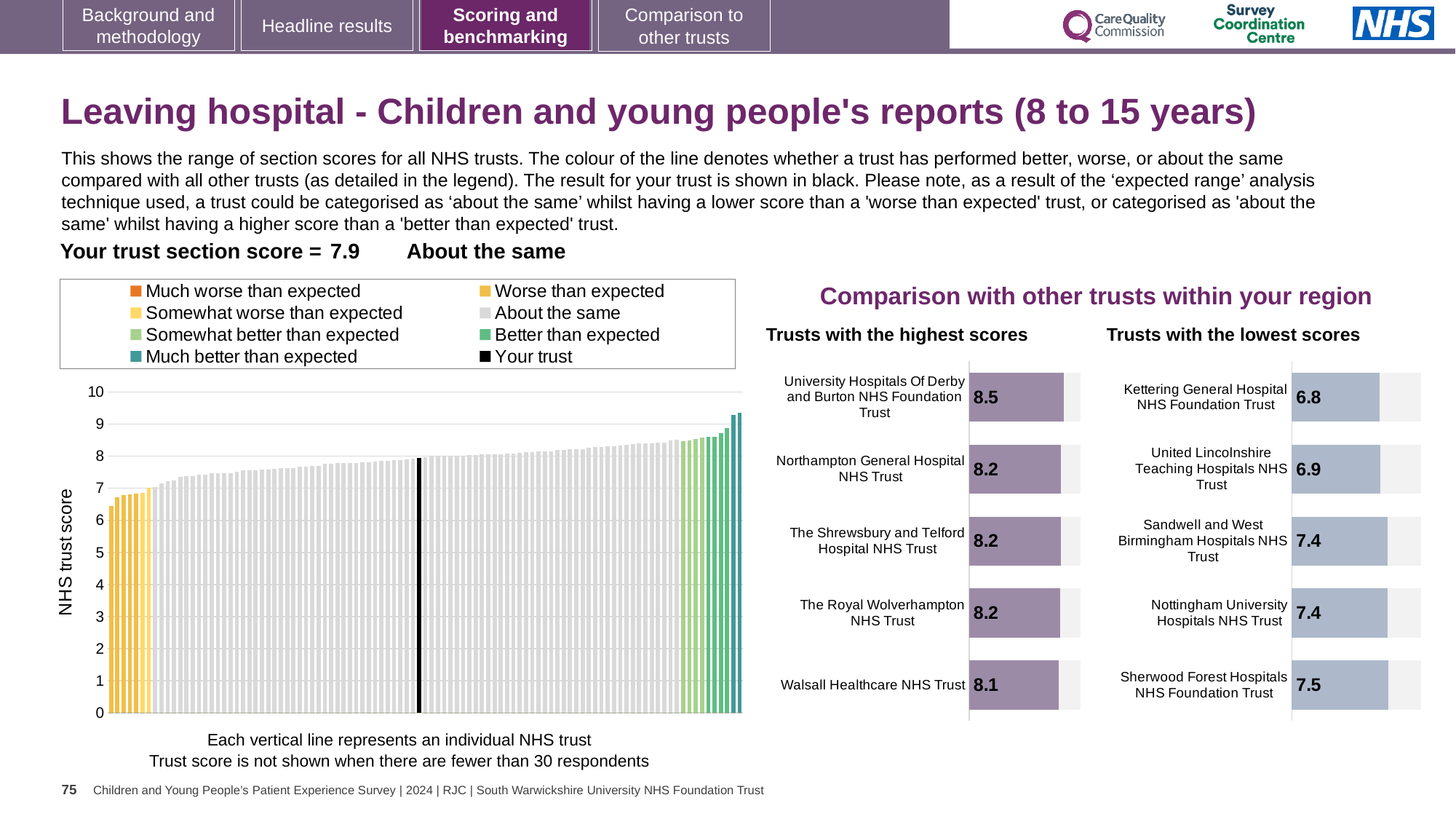
In the main chart on the left showing all NHS trusts, what is the section score for your trust (the black line)? 7.9 How many entries does the legend above the main chart on the left list? 8 In the 'Trusts with the lowest scores' chart, which has the higher score: United Lincolnshire Teaching Hospitals NHS Trust or Kettering General Hospital NHS Foundation Trust? United Lincolnshire Teaching Hospitals NHS Trust In the 'Trusts with the lowest scores' chart, what is the score for Kettering General Hospital NHS Foundation Trust? 6.8 In the 'Trusts with the highest scores' chart, which trust has the highest score? University Hospitals Of Derby and Burton NHS Foundation Trust In the 'Trusts with the highest scores' chart, what is the score for University Hospitals Of Derby and Burton NHS Foundation Trust? 8.5 In the 'Trusts with the highest scores' chart, what is the difference between the scores of University Hospitals Of Derby and Burton NHS Foundation Trust and Walsall Healthcare NHS Trust? 0.4 In the main chart on the left showing all NHS trusts, do the values rise or fall from left to right? rise In the 'Trusts with the lowest scores' chart, what is the difference between the scores of Sherwood Forest Hospitals NHS Foundation Trust and Kettering General Hospital NHS Foundation Trust? 0.7 In the 'Trusts with the highest scores' chart, how many trusts are shown? 5 In the 'Trusts with the lowest scores' chart, which trust has the lowest score? Kettering General Hospital NHS Foundation Trust In the main chart on the left showing all NHS trusts, is the value of the lowest bar greater or less than 7? less